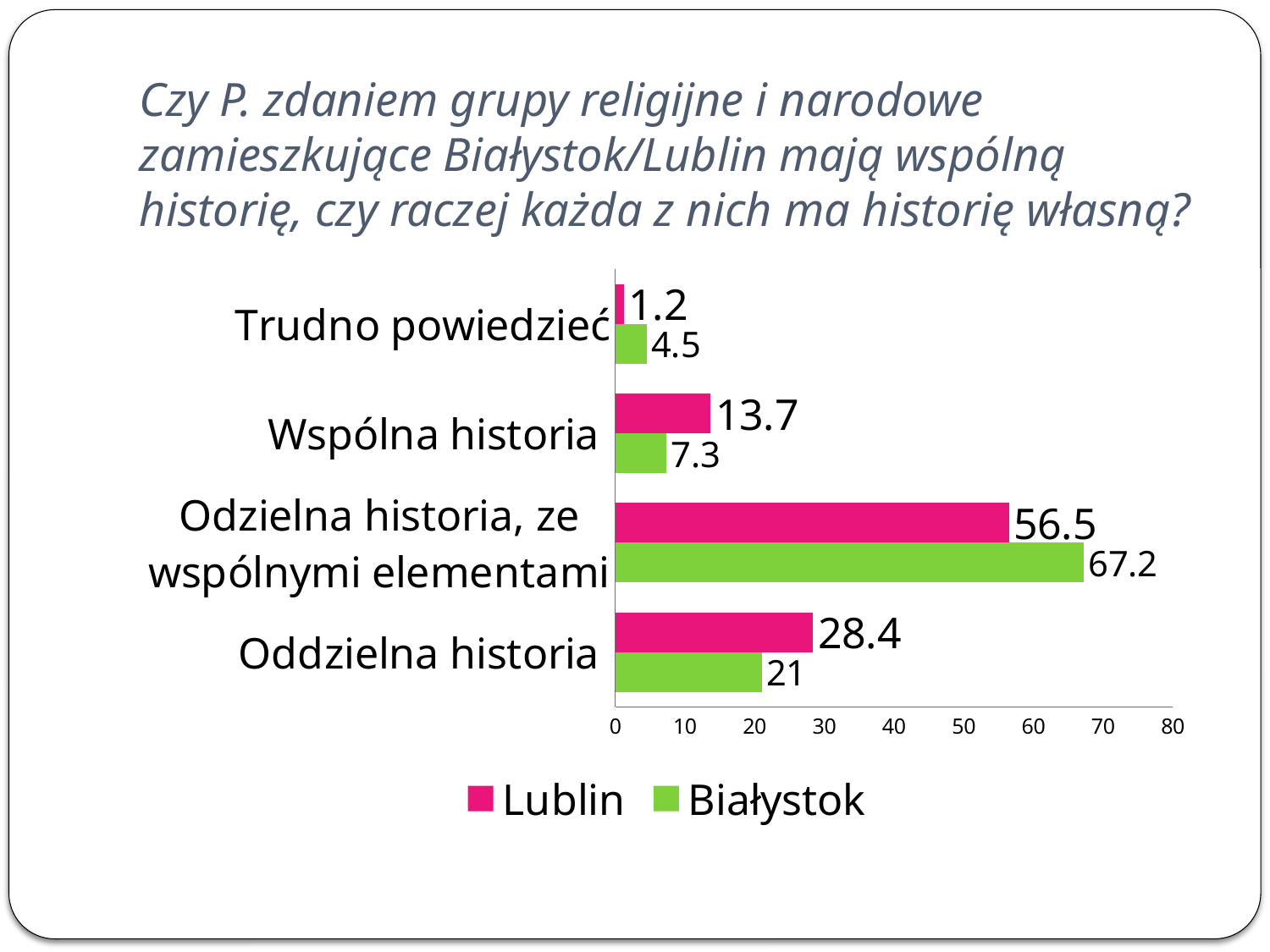
What is the value for Lublin in the "Oddzielna historia" category? 28.4 Which is larger in the "Oddzielna historia" category, the Lublin value or the Białystok value? Lublin Is the Lublin value for "Odzielna historia, ze wspólnymi elementami" greater or less than 50? greater Which category has the lowest value for Lublin? Trudno powiedzieć What is the value for Lublin in the "Wspólna historia" category? 13.7 What is the difference between the Białystok and Lublin values in the "Odzielna historia, ze wspólnymi elementami" category? 10.7 Which category has the highest value for Białystok? Odzielna historia, ze wspólnymi elementami How many series does the legend list? 2 What is the value for Białystok in the "Odzielna historia, ze wspólnymi elementami" category? 67.2 How many categories are shown on the chart? 4 What is the value for Białystok in the "Trudno powiedzieć" category? 4.5 What kind of chart is shown on the slide? bar chart